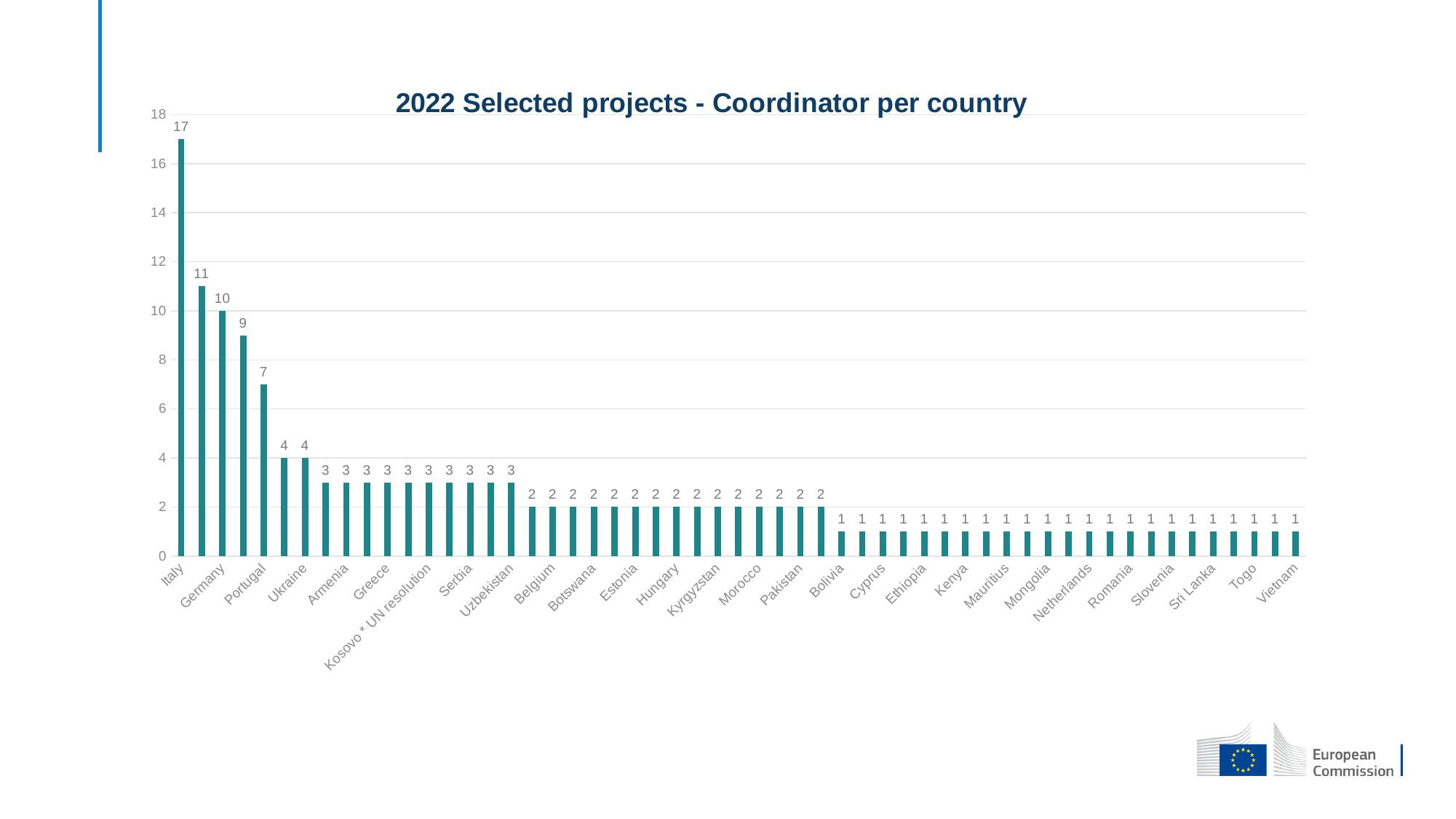
How many coordinators does Italy have? 17 What type of chart is shown on the slide? bar chart How many coordinators does Greece have? 3 What is the title of the chart? 2022 Selected projects - Coordinator per country Do the values rise or fall from left to right along the x axis? fall What is the difference between the values for Italy and Vietnam? 16 Which country has the highest number of coordinators? Italy Is the value for Italy greater or less than 16? greater How many coordinators does Vietnam have? 1 Which has a larger value, Italy or Ukraine? Italy How many coordinators does Ukraine have? 4 How many coordinators does Belgium have? 2